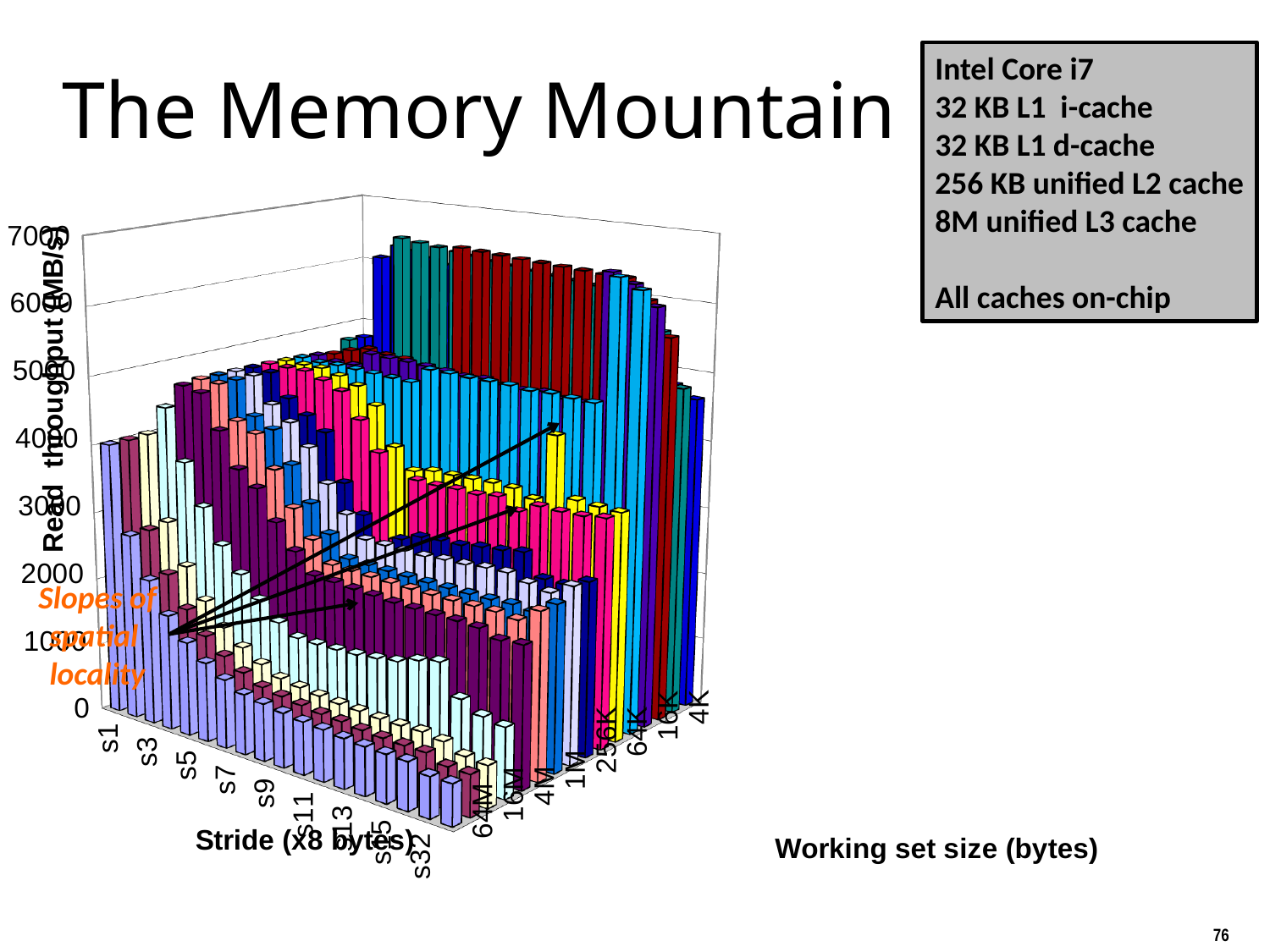
What is the title of the chart on the slide? The Memory Mountain What is the label of the vertical axis of the chart? Read throughput (MB/s) What is the smallest working set size labeled on the chart? 4K What kind of chart is shown on the slide? bar chart How many stride labels are shown along the stride axis of the chart? 9 What is the highest tick value shown on the read throughput axis? 7000 For the 64M working set size (front row), does read throughput rise or fall as the stride increases from s1 to s32? fall What is the largest working set size labeled on the chart? 64M How many working set size labels are shown along the depth axis of the chart? 8